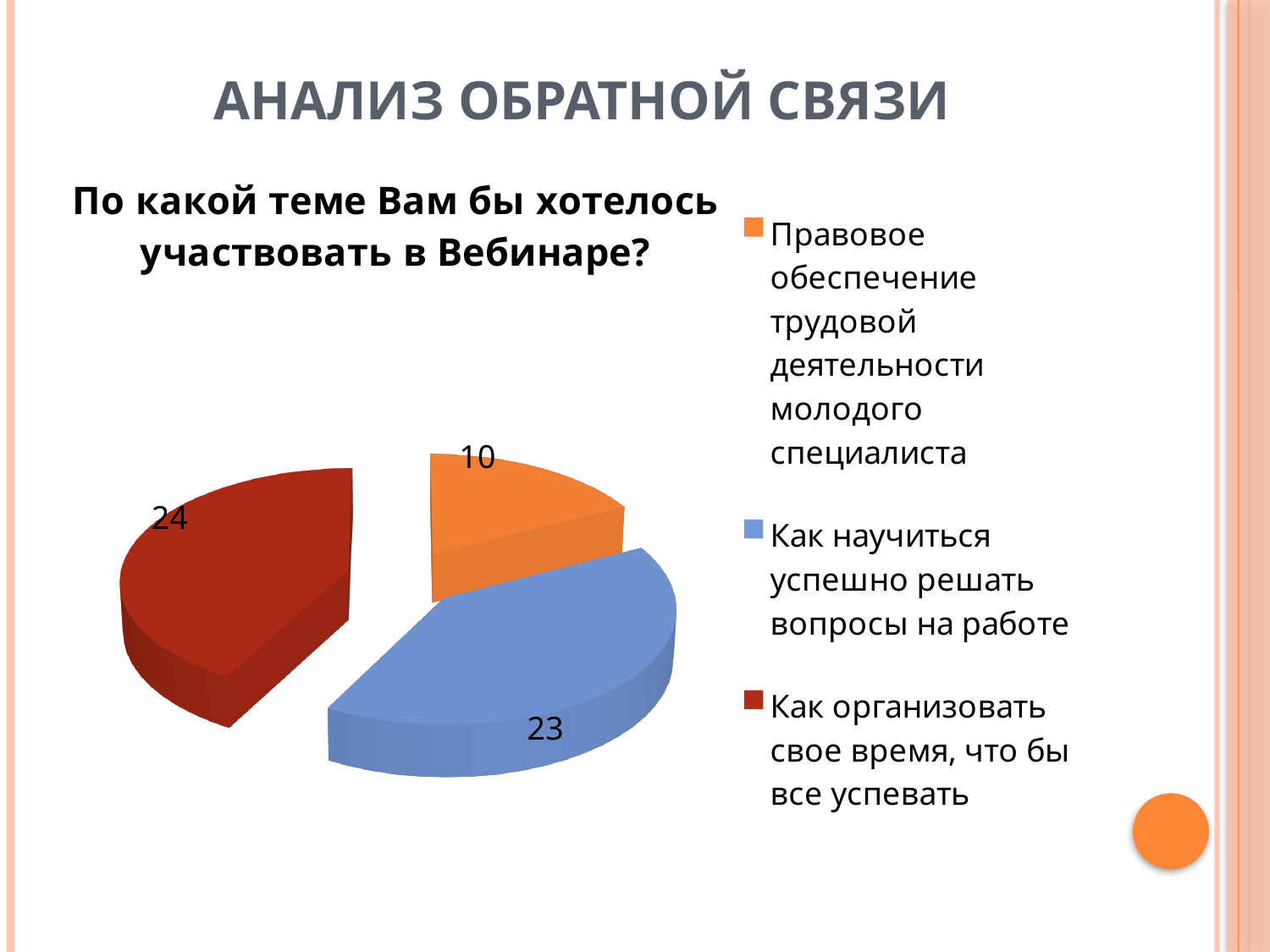
Which category has the highest value? Как организовать свое время, что бы все успевать What kind of chart is shown on the slide? pie chart What is the title of the chart? По какой теме Вам бы хотелось участвовать в Вебинаре? What is the value for "Как организовать свое время, что бы все успевать"? 24 What is the difference between the values for "Как организовать свое время, что бы все успевать" and "Как научиться успешно решать вопросы на работе"? 1 How many slices does the pie chart have? 3 Which is larger: the value for "Как научиться успешно решать вопросы на работе" or the value for "Правовое обеспечение трудовой деятельности молодого специалиста"? Как научиться успешно решать вопросы на работе Which category has the lowest value? Правовое обеспечение трудовой деятельности молодого специалиста What is the value for "Правовое обеспечение трудовой деятельности молодого специалиста"? 10 What is the value for "Как научиться успешно решать вопросы на работе"? 23 What is the difference between the values for "Как организовать свое время, что бы все успевать" and "Правовое обеспечение трудовой деятельности молодого специалиста"? 14 What is the total of all the values in the pie chart? 57